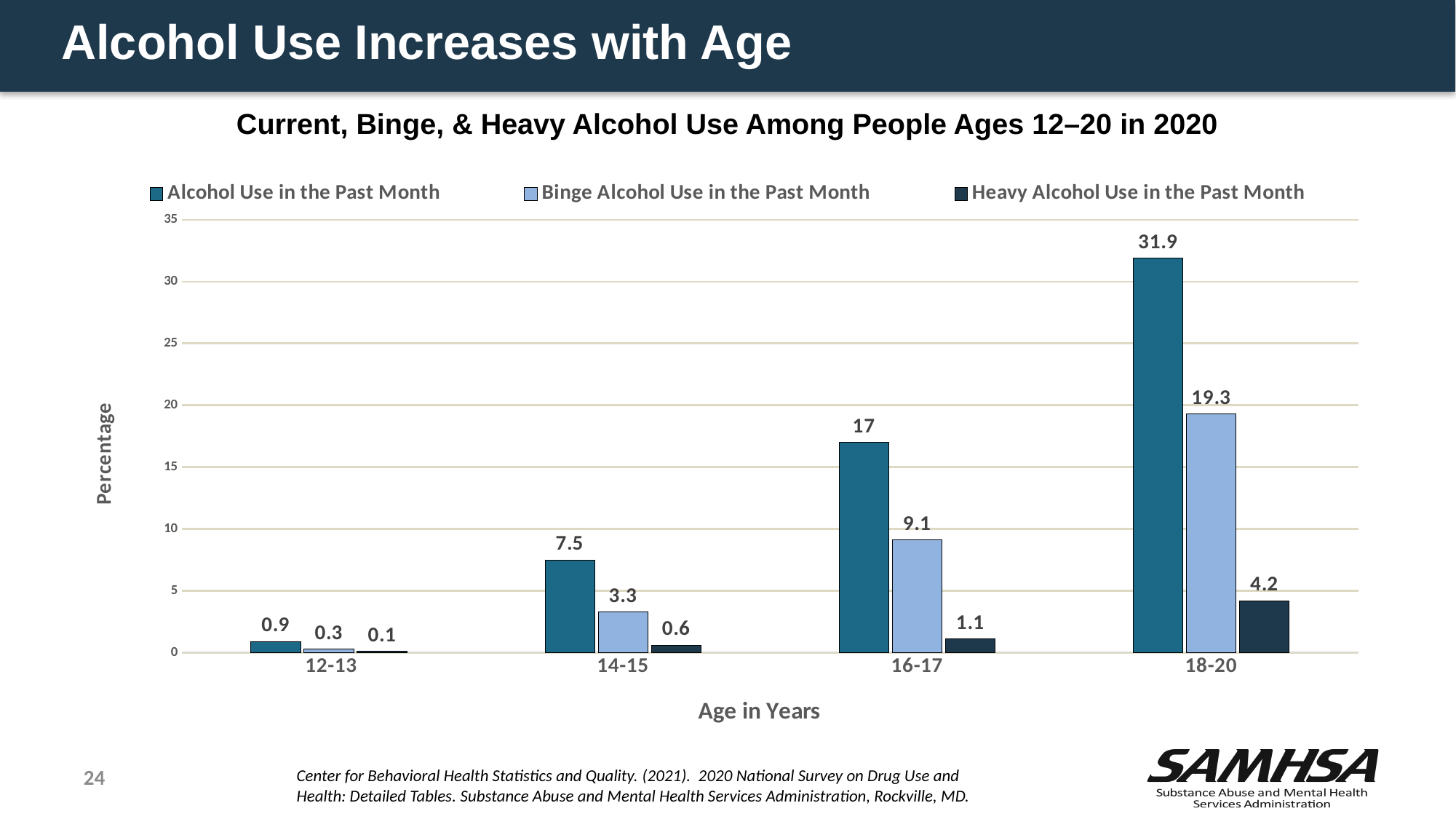
Is the value for Alcohol Use in the Past Month for ages 16-17 greater or less than 15? greater What is the value for Alcohol Use in the Past Month for ages 18-20? 31.9 What is the value for Binge Alcohol Use in the Past Month for ages 14-15? 3.3 Do the values for Heavy Alcohol Use in the Past Month rise or fall as age increases along the x axis? rise What is the difference between Alcohol Use in the Past Month and Binge Alcohol Use in the Past Month for ages 18-20? 12.6 Which is larger: Binge Alcohol Use in the Past Month for ages 16-17 or Alcohol Use in the Past Month for ages 14-15? Binge Alcohol Use in the Past Month for ages 16-17 What kind of chart is shown on the slide? bar chart How many age groups are shown on the x axis? 4 Which age group has the highest value for Binge Alcohol Use in the Past Month? 18-20 Which age group has the lowest value for Alcohol Use in the Past Month? 12-13 How many series does the legend list? 3 What is the value for Heavy Alcohol Use in the Past Month for ages 16-17? 1.1